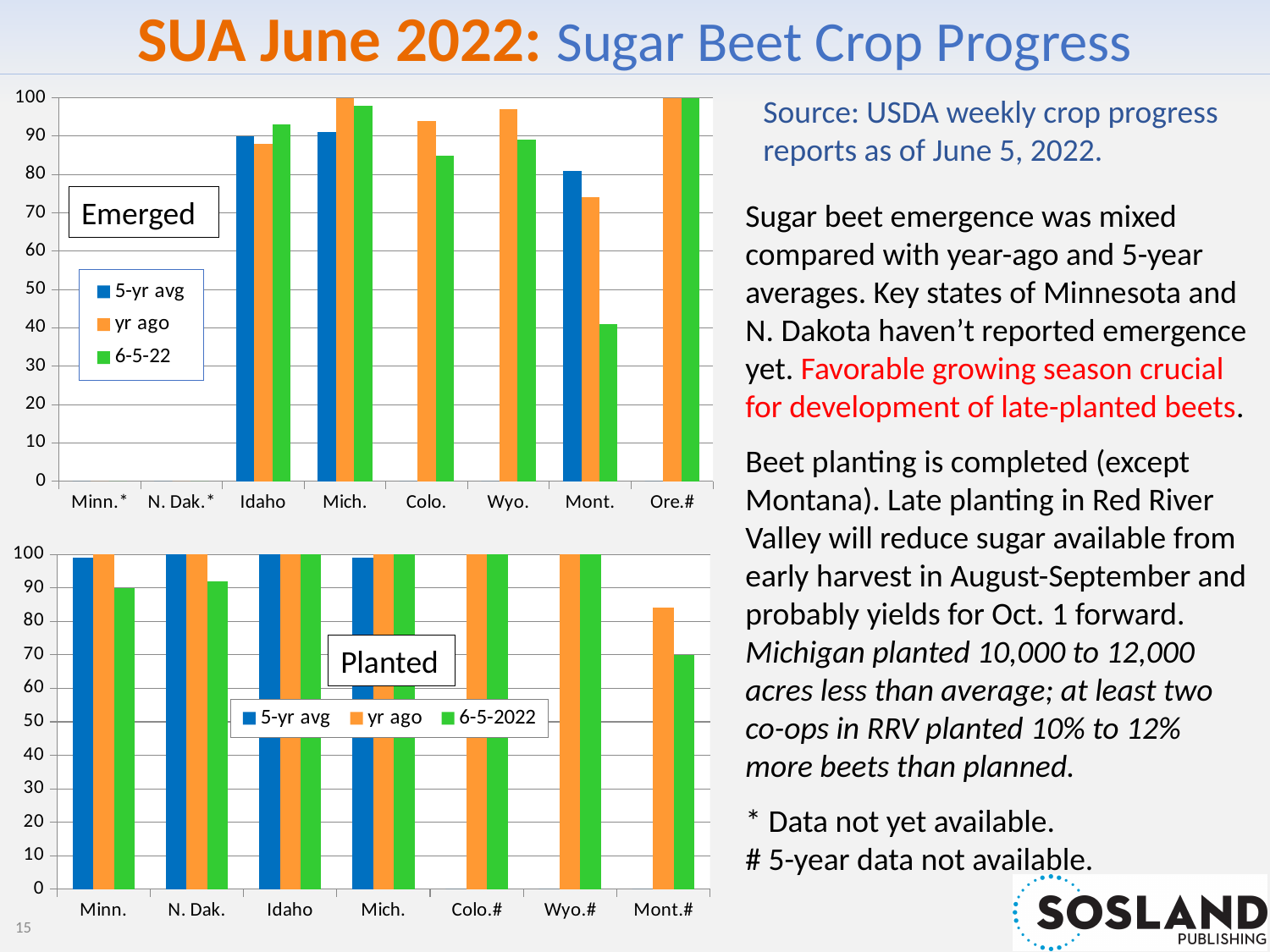
What type of chart is the Emerged chart at the top of the slide? bar chart In the Planted chart, is the 6-5-2022 value for Mont.# greater or less than 80? less In the Emerged chart, is the yr ago value for Colo. greater or less than 90? greater How many series does the legend of the Emerged chart list? 3 In the Planted chart, which is larger for Mont.#: the yr ago value or the 6-5-2022 value? yr ago How many state categories are shown on the x axis of the Planted chart? 7 In the Emerged chart, what is the yr ago value for Mich.? 100 In the Emerged chart, is the 6-5-22 value for Mont. greater or less than 50? less In the Planted chart, what is the 6-5-2022 value for Idaho? 100 In the Emerged chart, which is larger for Mont.: the 5-yr avg value or the 6-5-22 value? 5-yr avg How many state categories are shown on the x axis of the Emerged chart? 8 In the Emerged chart, what is the 6-5-22 value for Ore.#? 100